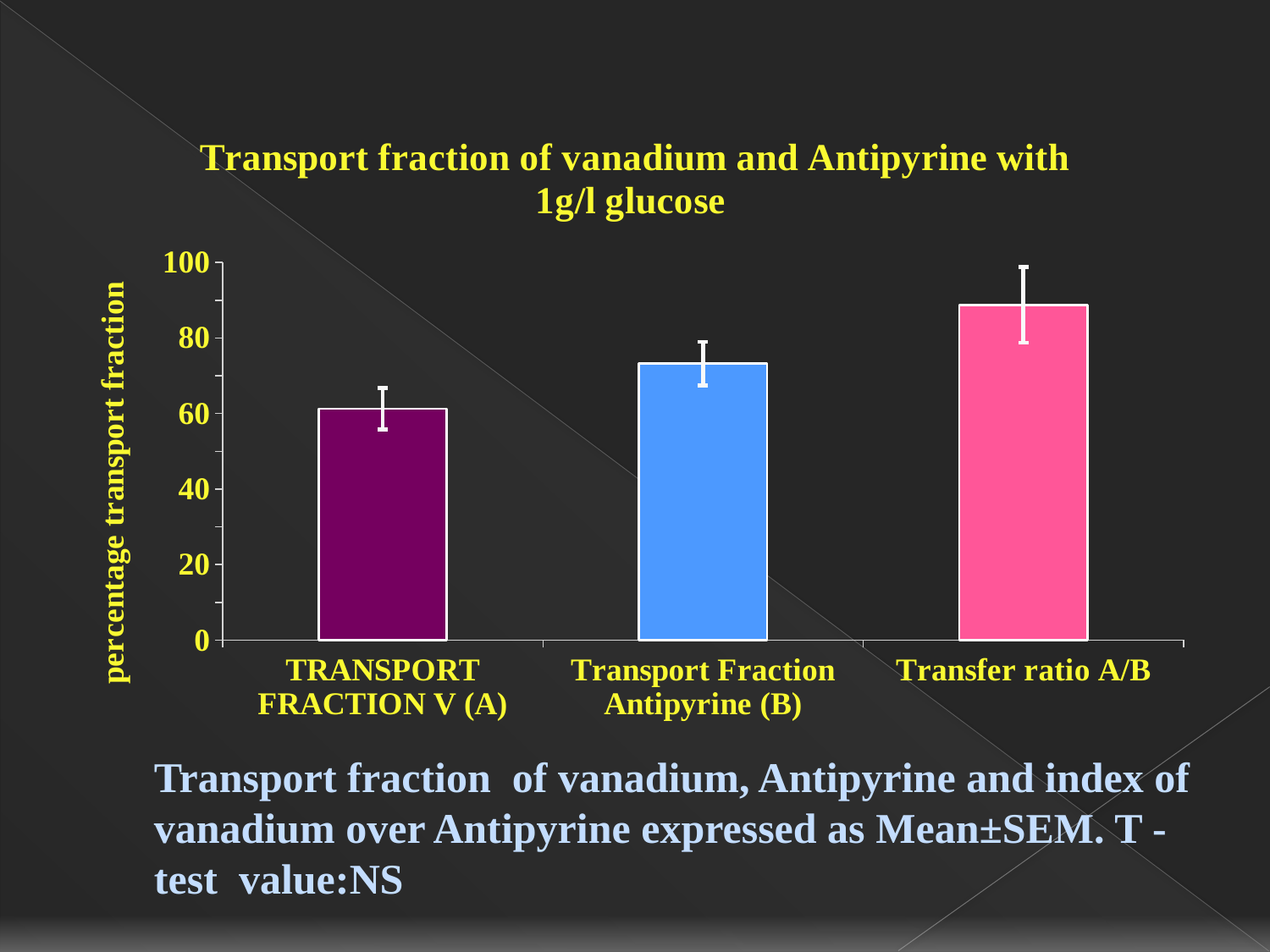
What kind of chart is shown on the slide? bar chart Is the value for Transport Fraction Antipyrine (B) greater or less than 60? greater Which category has the highest bar? Transfer ratio A/B What is the label on the vertical axis of the chart? percentage transport fraction Is the value for TRANSPORT FRACTION V (A) greater or less than 80? less Which is larger, the bar for Transport Fraction Antipyrine (B) or the bar for TRANSPORT FRACTION V (A)? Transport Fraction Antipyrine (B) What is the title of the chart? Transport fraction of vanadium and Antipyrine with 1g/l glucose How many bars are plotted in the chart? 3 Is the value for Transport Fraction Antipyrine (B) greater or less than 80? less Do the bar values rise or fall from left to right across the categories? rise Which category has the lowest bar? TRANSPORT FRACTION V (A)